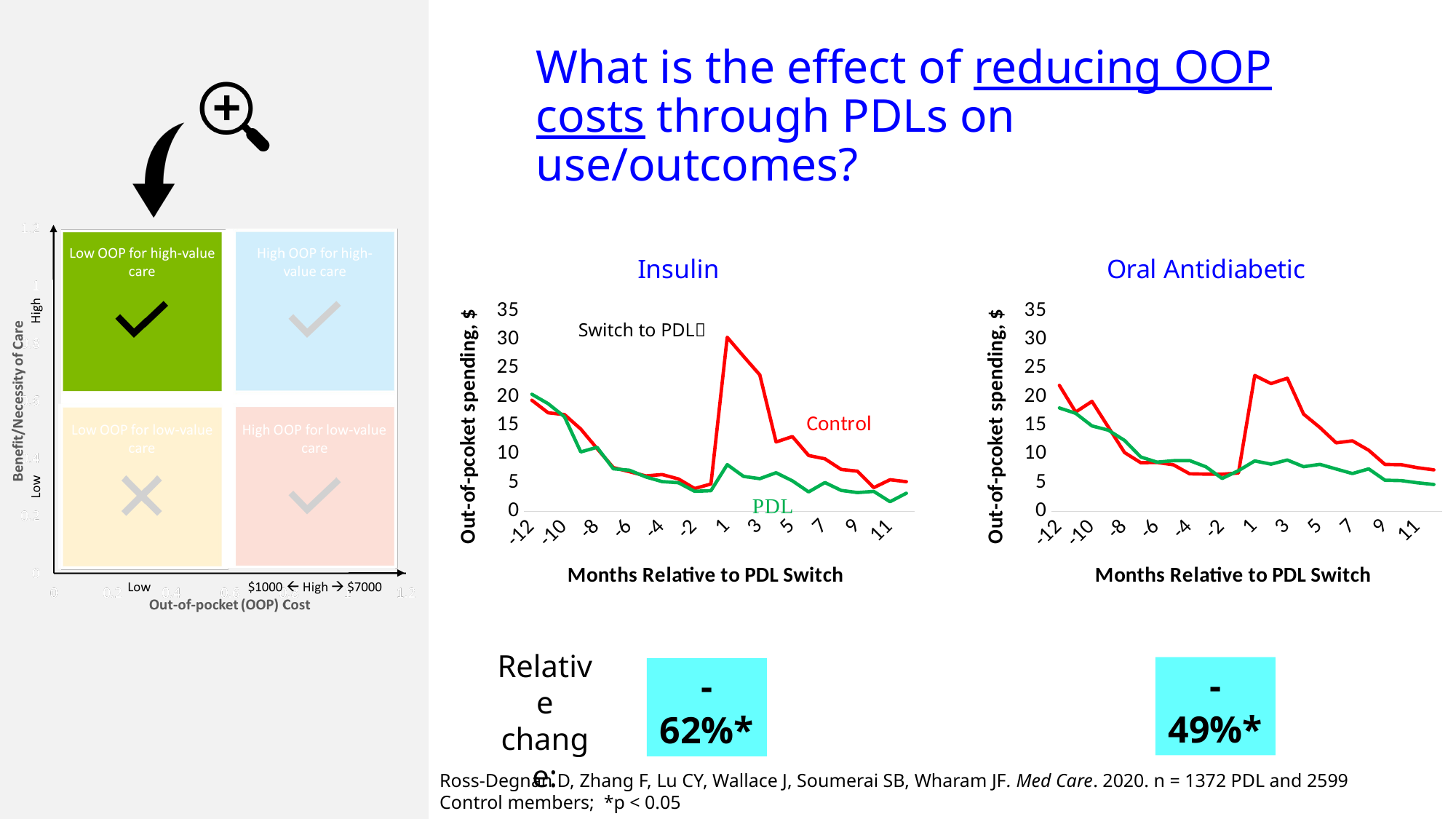
How many series are plotted in the Oral Antidiabetic chart? 2 In the Insulin chart, does the PDL series rise or fall from month -12 to month -2? fall In the Oral Antidiabetic chart, is the PDL value at month 11 greater or less than 10? less In the Oral Antidiabetic chart, which series has the higher value at month 3, Control or PDL? Control In the Insulin chart, is the Control value at month 1 greater or less than 25? greater What kind of chart is the Insulin chart? line chart In the Insulin chart, what colour is the Control line? red In the Insulin chart, which series has the higher value at month 1, Control or PDL? Control In the Insulin chart, is the PDL value at month 1 greater or less than 10? less In the Insulin chart, at which month does the Control series reach its highest value? 1 What is the x-axis label of the Oral Antidiabetic chart? Months Relative to PDL Switch